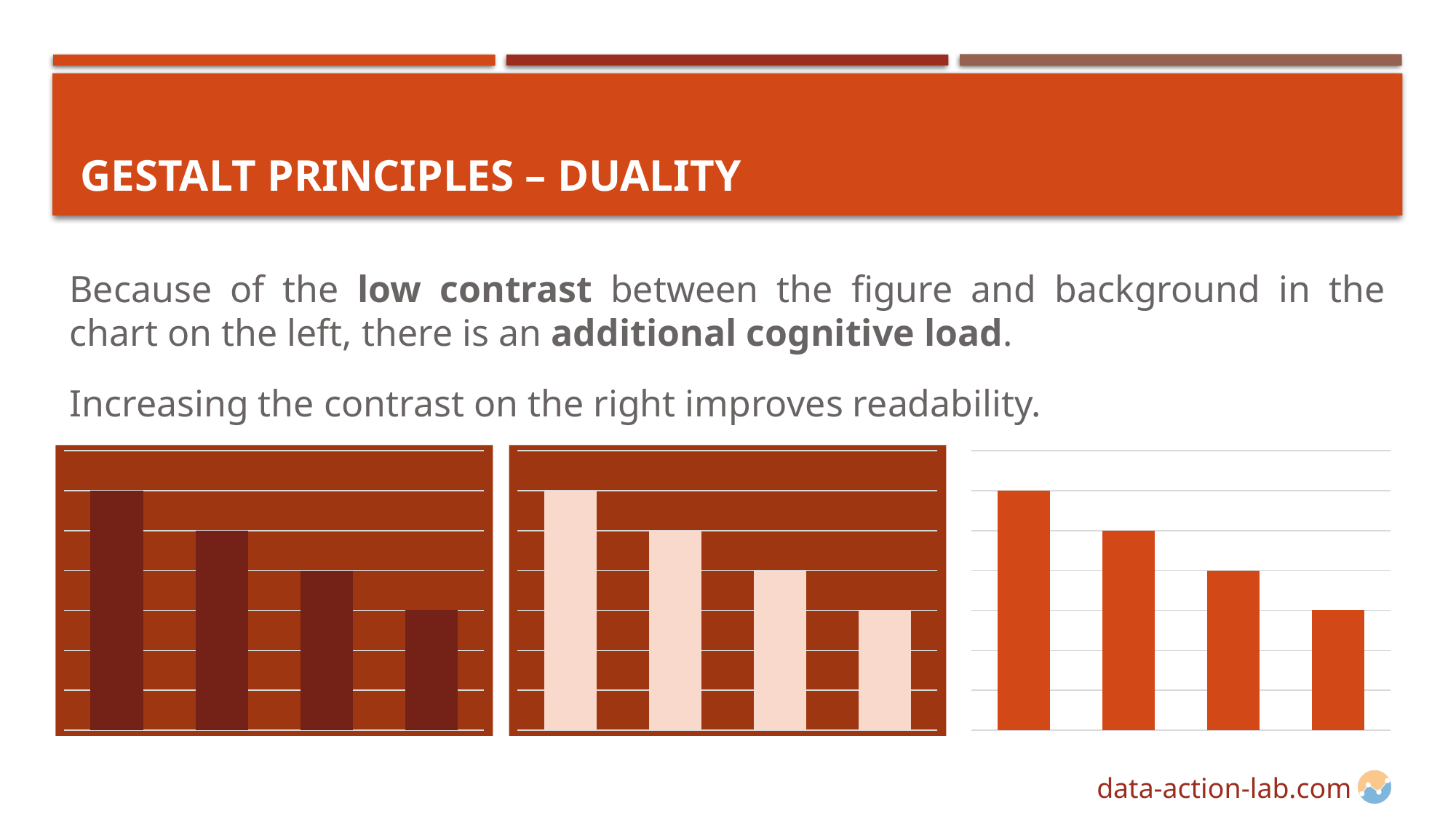
What colour is the background of the leftmost chart? dark orange-red How many bars does the middle chart show? 4 How many bars does the rightmost chart show? 4 In the middle chart, is the second bar taller or shorter than the third bar? taller How many bars does the leftmost chart show? 4 What colour are the bars in the middle chart? light pink In the rightmost chart, do the bar heights rise or fall from left to right? fall In the rightmost chart, which bar is the shortest? the fourth (rightmost) bar In the leftmost chart, which bar is the tallest? the first (leftmost) bar What kind of chart is the leftmost chart on the slide? bar chart In the middle chart, do the bar heights rise or fall from left to right? fall